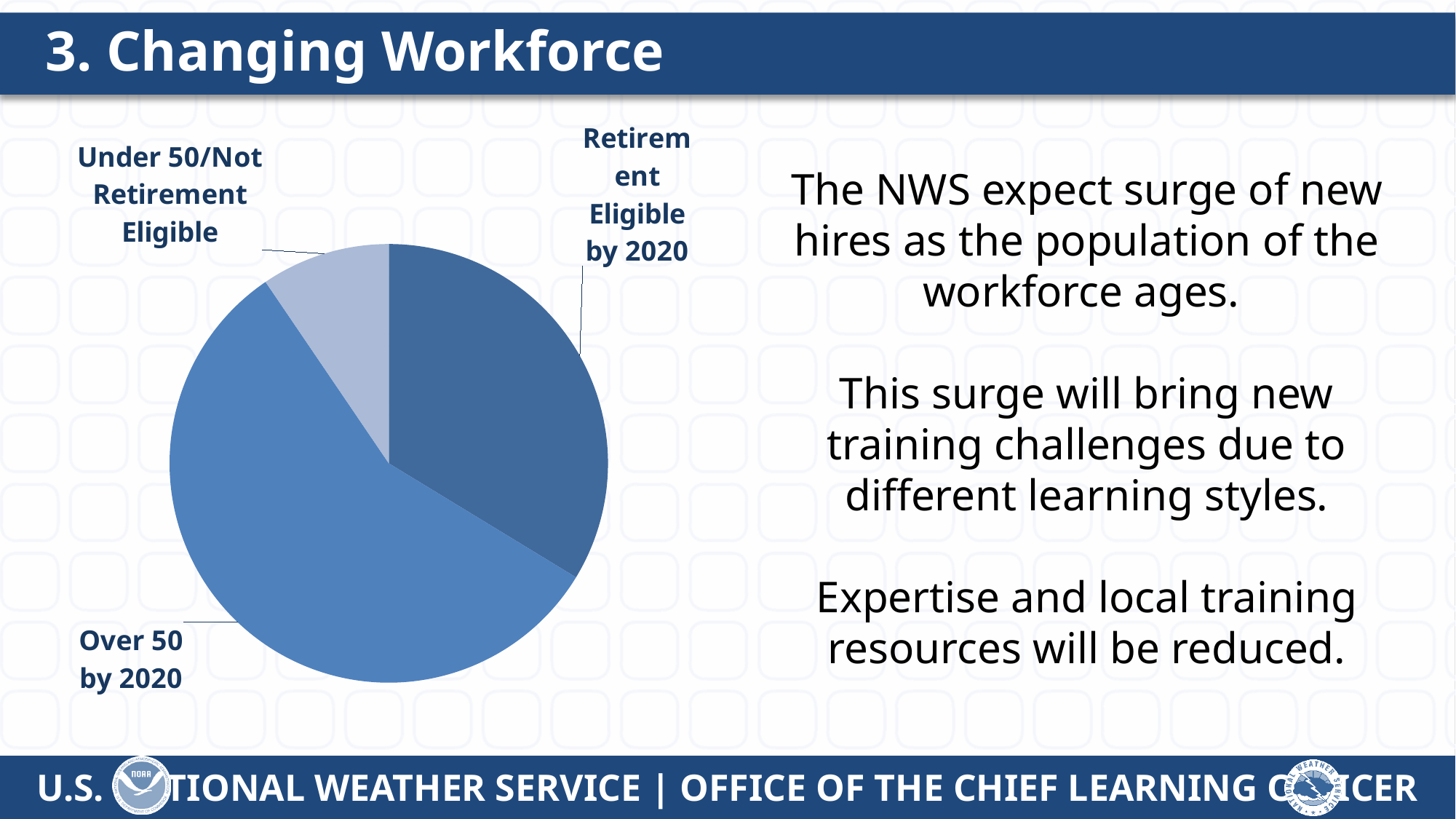
Which category is shown in the darkest shade of blue in the pie chart? Retirement Eligible by 2020 Does the Over 50 by 2020 slice take up more or less than half of the pie? more Which category has the largest slice of the pie chart? Over 50 by 2020 Which slice is larger: Retirement Eligible by 2020 or Under 50/Not Retirement Eligible? Retirement Eligible by 2020 Which slice is larger: Over 50 by 2020 or Retirement Eligible by 2020? Over 50 by 2020 Which category is shown in the lightest shade of blue in the pie chart? Under 50/Not Retirement Eligible Which category has the smallest slice of the pie chart? Under 50/Not Retirement Eligible How many slices does the pie chart have? 3 What kind of chart is shown on the slide? pie chart Does the Under 50/Not Retirement Eligible slice take up more or less than a quarter of the pie? less